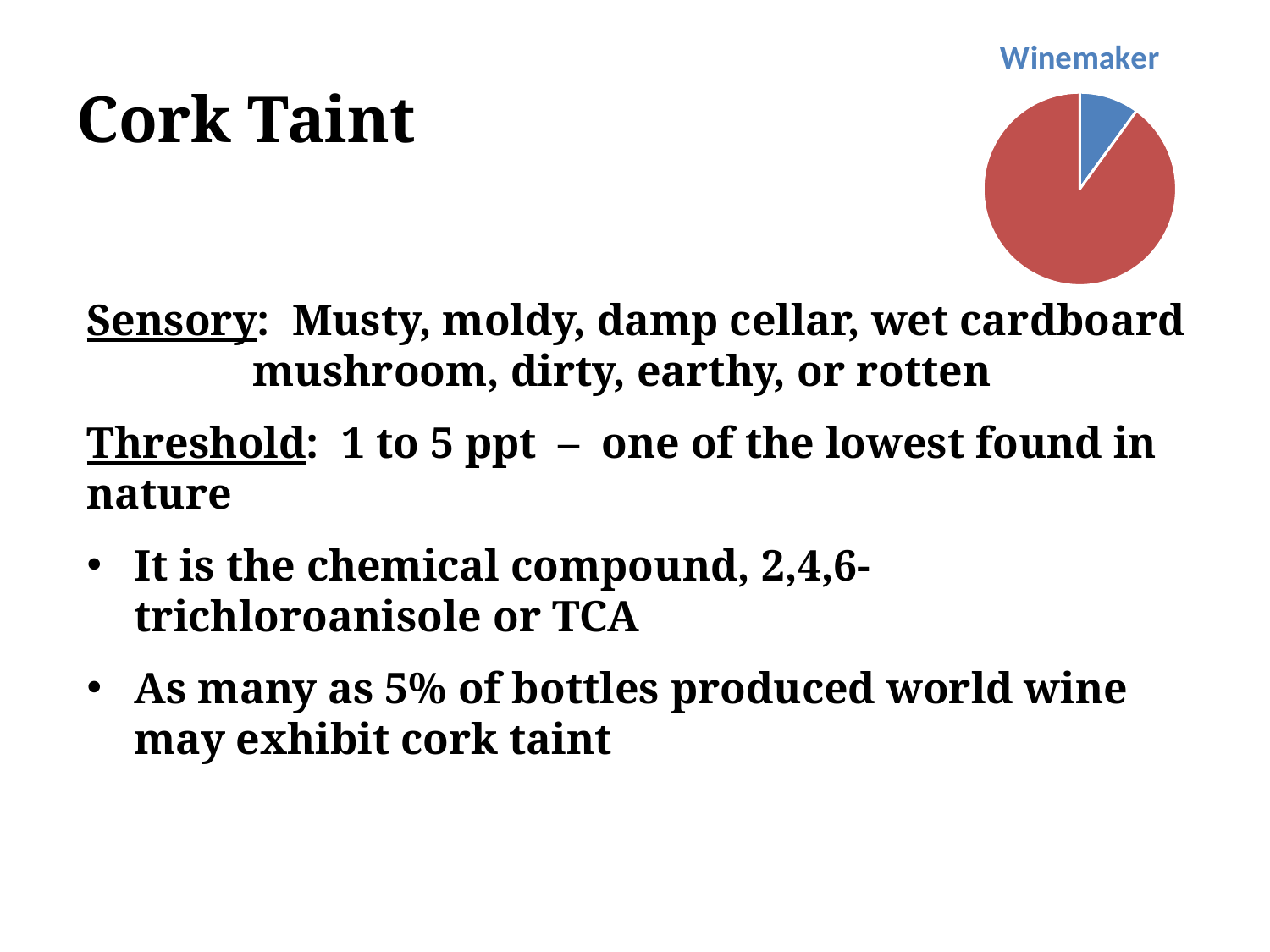
In the "Winemaker" pie chart, which slice is larger, the red one or the blue one? the red one What kind of chart is the "Winemaker" chart on the slide? pie chart In the "Winemaker" pie chart, which colour slice is the smallest? blue What is the title of the pie chart on the slide? Winemaker How many slices does the "Winemaker" pie chart have? 2 In the "Winemaker" pie chart, which colour slice is the largest? red What two colours are used for the slices of the "Winemaker" pie chart? red and blue